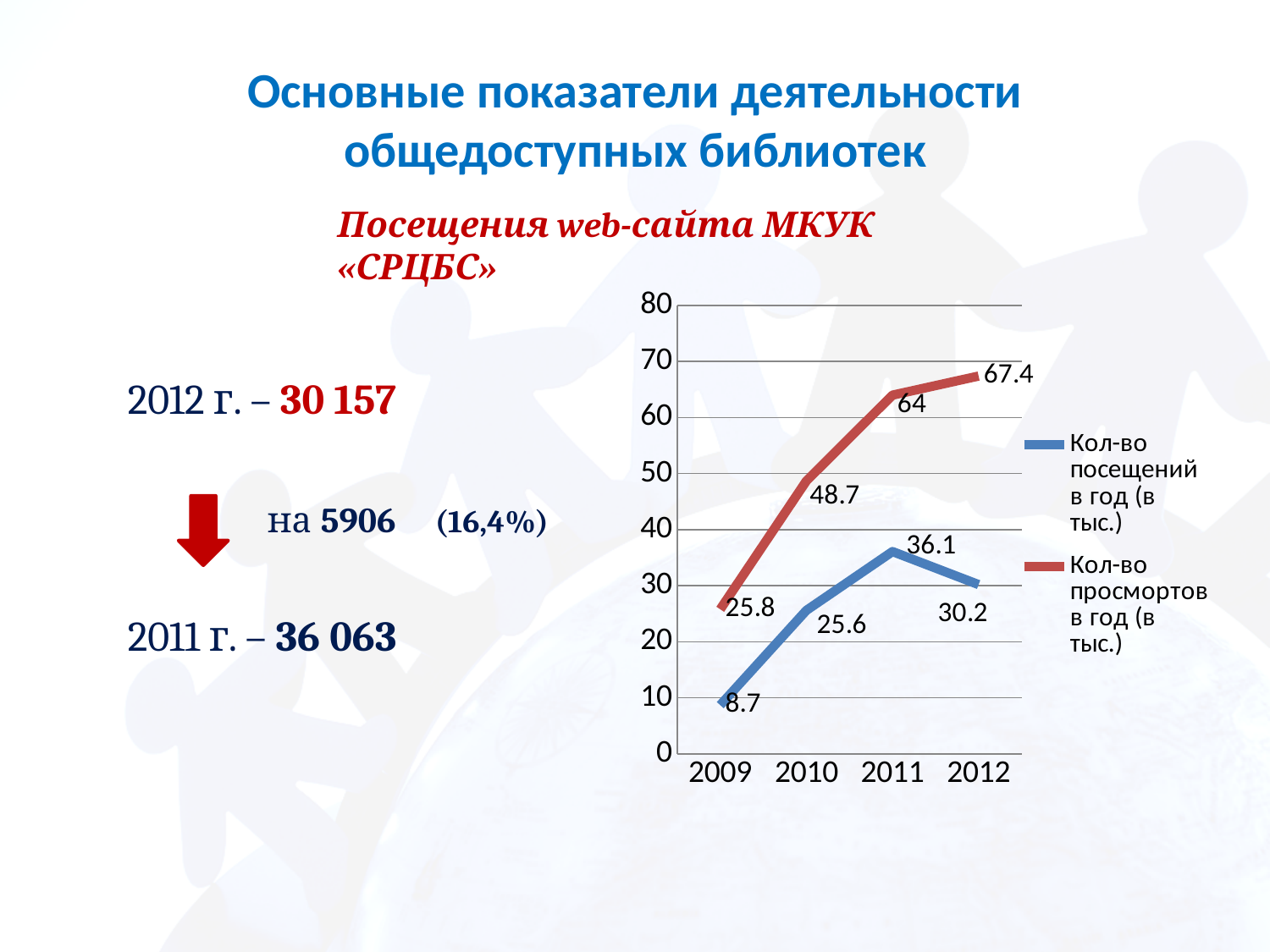
Which is larger in 2012: 'Кол-во посещений в год (в тыс.)' or 'Кол-во просмортов в год (в тыс.)'? Кол-во просмортов в год (в тыс.) What is the value of 'Кол-во просмортов в год (в тыс.)' in 2012? 67.4 What is the difference between 'Кол-во просмортов в год (в тыс.)' and 'Кол-во посещений в год (в тыс.)' in 2010? 23.1 What is the value of 'Кол-во посещений в год (в тыс.)' in 2011? 36.1 Which colour is used for the 'Кол-во просмортов в год (в тыс.)' series? red How many series does the chart legend list? 2 What is the value of 'Кол-во посещений в год (в тыс.)' in 2009? 8.7 In which year is 'Кол-во просмортов в год (в тыс.)' the highest? 2012 Does 'Кол-во посещений в год (в тыс.)' rise or fall from 2011 to 2012? fall What type of chart is shown on the slide? line chart In which year is 'Кол-во посещений в год (в тыс.)' the lowest? 2009 How many years are plotted along the x axis of the chart? 4